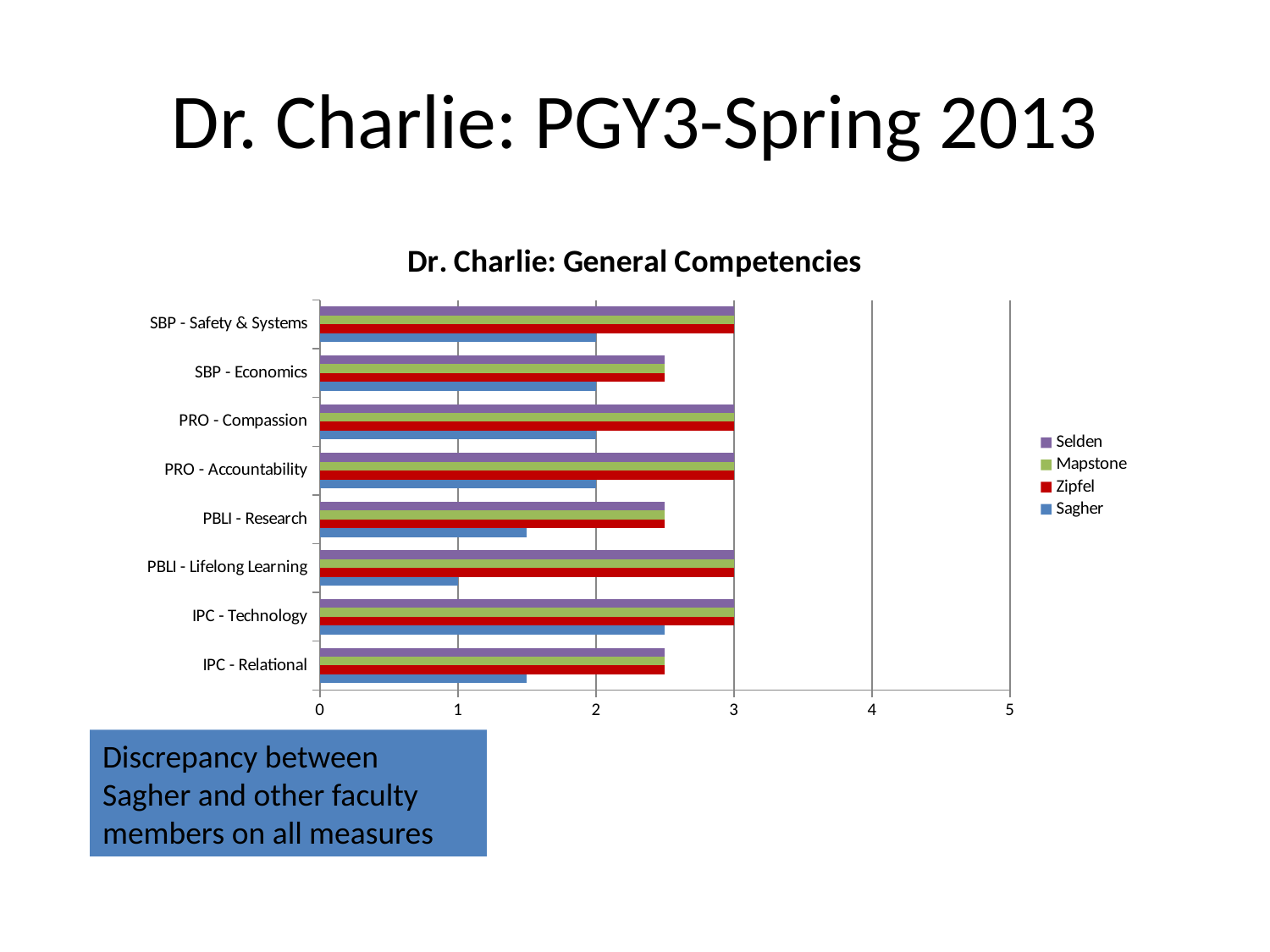
What is the title of the chart? Dr. Charlie: General Competencies How many series does the legend list? 4 What kind of chart is shown on the slide? bar chart Which faculty member is represented by the blue bars? Sagher For which category is Sagher's value lowest? PBLI - Lifelong Learning What is Sagher's value for SBP - Safety & Systems? 2 Is Selden's value for SBP - Economics greater or less than 2? greater What is Sagher's value for PBLI - Lifelong Learning? 1 Is Sagher's value for PBLI - Research greater or less than 2? less What is Zipfel's value for PRO - Compassion? 3 For IPC - Technology, which is larger: Mapstone's value or Sagher's value? Mapstone How many competency categories are listed on the chart? 8